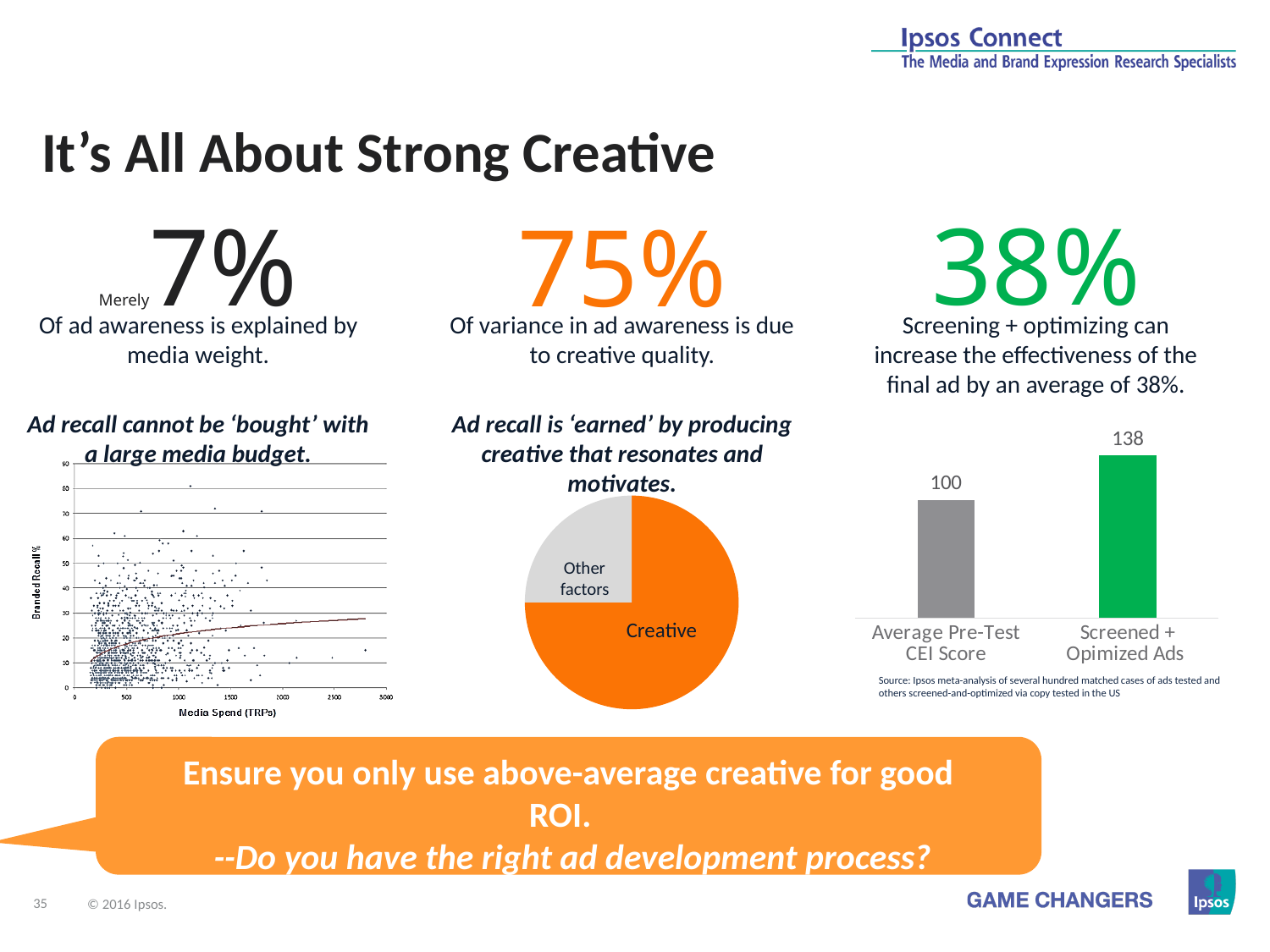
In the bar chart on the right, which category has the lowest value? Average Pre-Test CEI Score In the bar chart on the right, what is the difference between Screened + Opimized Ads and Average Pre-Test CEI Score? 38 In the scatter plot on the left, what is the label of the x axis? Media Spend (TRPs) In the bar chart on the right, which category has the highest value? Screened + Opimized Ads In the pie chart in the middle of the slide, which slice is larger, Creative or Other factors? Creative In the bar chart on the right, what is the value for Average Pre-Test CEI Score? 100 What type of chart is shown on the right side of the slide, below the 38% figure? bar chart How many bars are in the bar chart on the right side of the slide? 2 What type of chart is shown in the middle of the slide, below the 75% figure? pie chart What type of chart is shown on the left side of the slide, below the 7% figure? scatter plot In the bar chart on the right, what is the value for Screened + Opimized Ads? 138 How many slices does the pie chart in the middle of the slide have? 2